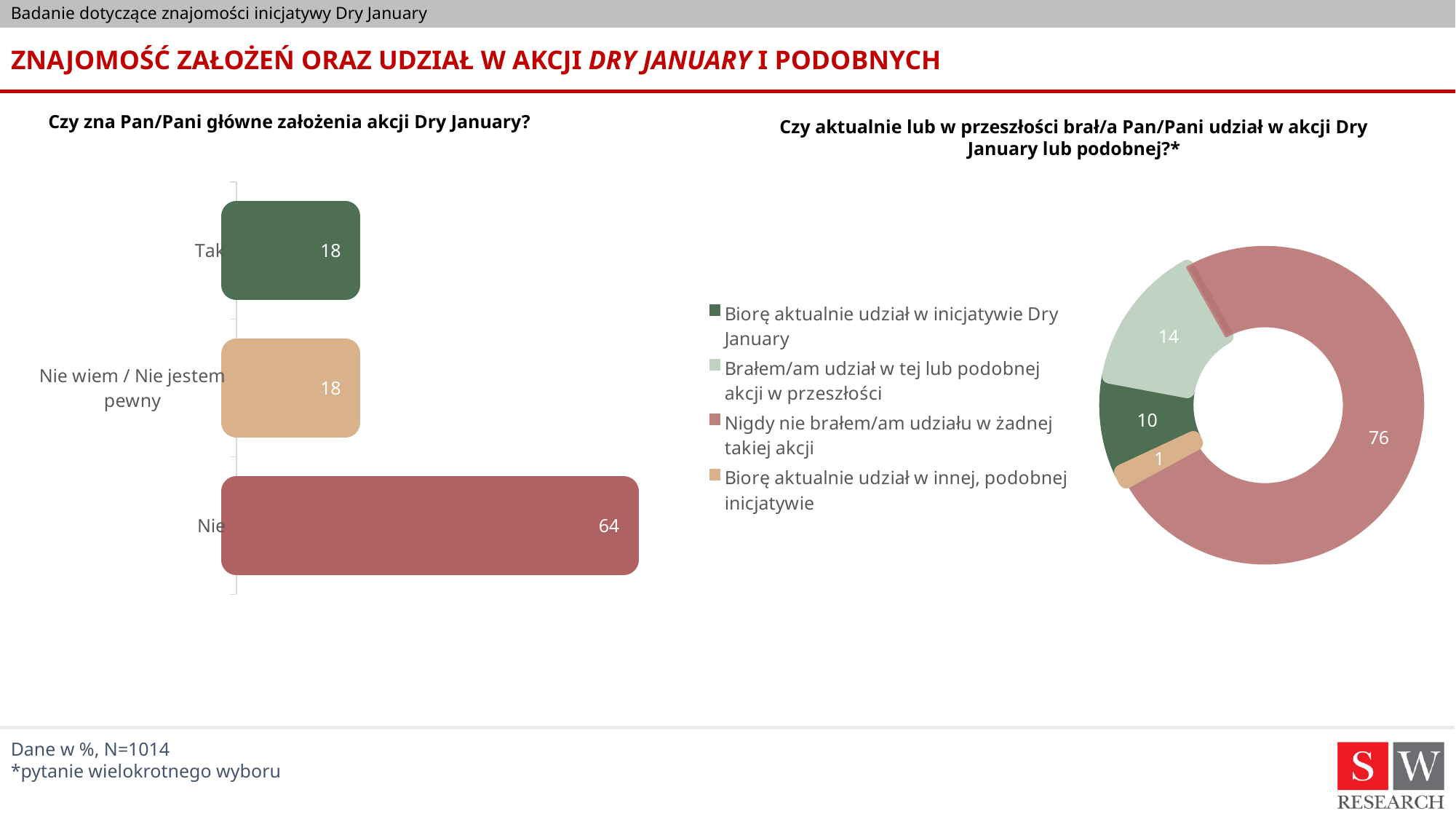
In the left chart 'Czy zna Pan/Pani główne założenia akcji Dry January?', what is the value for 'Tak'? 18 In the left chart 'Czy zna Pan/Pani główne założenia akcji Dry January?', which category has the highest value? Nie In the left chart 'Czy zna Pan/Pani główne założenia akcji Dry January?', what is the difference between the values for 'Nie' and 'Tak'? 46 In the left chart 'Czy zna Pan/Pani główne założenia akcji Dry January?', what is the value for 'Nie'? 64 In the right chart 'Czy aktualnie lub w przeszłości brał/a Pan/Pani udział w akcji Dry January lub podobnej?', what is the value for 'Biorę aktualnie udział w inicjatywie Dry January'? 10 In the right chart 'Czy aktualnie lub w przeszłości brał/a Pan/Pani udział w akcji Dry January lub podobnej?', which is larger: 'Brałem/am udział w tej lub podobnej akcji w przeszłości' or 'Biorę aktualnie udział w inicjatywie Dry January'? Brałem/am udział w tej lub podobnej akcji w przeszłości In the right chart 'Czy aktualnie lub w przeszłości brał/a Pan/Pani udział w akcji Dry January lub podobnej?', how many entries does the legend list? 4 In the right chart 'Czy aktualnie lub w przeszłości brał/a Pan/Pani udział w akcji Dry January lub podobnej?', what is the value for 'Nigdy nie brałem/am udziału w żadnej takiej akcji'? 76 In the right chart 'Czy aktualnie lub w przeszłości brał/a Pan/Pani udział w akcji Dry January lub podobnej?', which category has the lowest value? Biorę aktualnie udział w innej, podobnej inicjatywie What kind of chart is the right chart 'Czy aktualnie lub w przeszłości brał/a Pan/Pani udział w akcji Dry January lub podobnej?'? Doughnut chart In the left chart 'Czy zna Pan/Pani główne założenia akcji Dry January?', how many categories are shown? 3 What kind of chart is the left chart 'Czy zna Pan/Pani główne założenia akcji Dry January?'? Bar chart